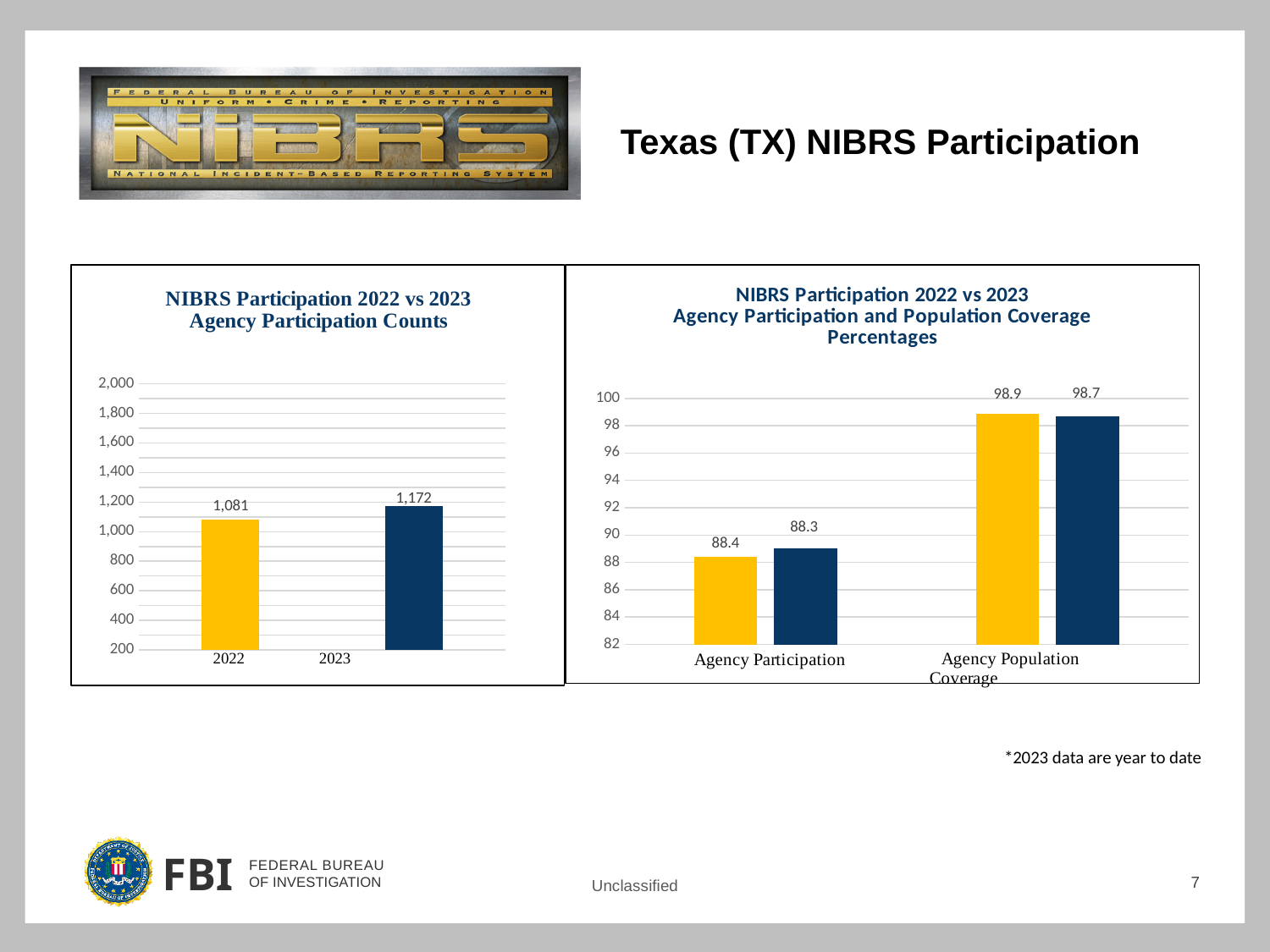
In the right chart (Percentages), what is the value of the yellow bar for Agency Population Coverage? 98.9 In the right chart (Percentages), what is the value of the blue bar for Agency Population Coverage? 98.7 In the left chart (Agency Participation Counts), what is the value for 2023? 1,172 In the right chart (Percentages), how many categories are shown on the x axis? 2 In the left chart (Agency Participation Counts), which year has the higher count? 2023 What kind of chart is the left chart (Agency Participation Counts)? bar chart In the right chart (Percentages), is the blue bar for Agency Participation greater or less than 90? less In the left chart (Agency Participation Counts), is the value for 2022 greater or less than 1,200? less In the left chart (Agency Participation Counts), what is the difference between the 2023 and 2022 values? 91 In the left chart (Agency Participation Counts), what is the value for 2022? 1,081 In the right chart (Percentages), what is the value of the yellow bar for Agency Participation? 88.4